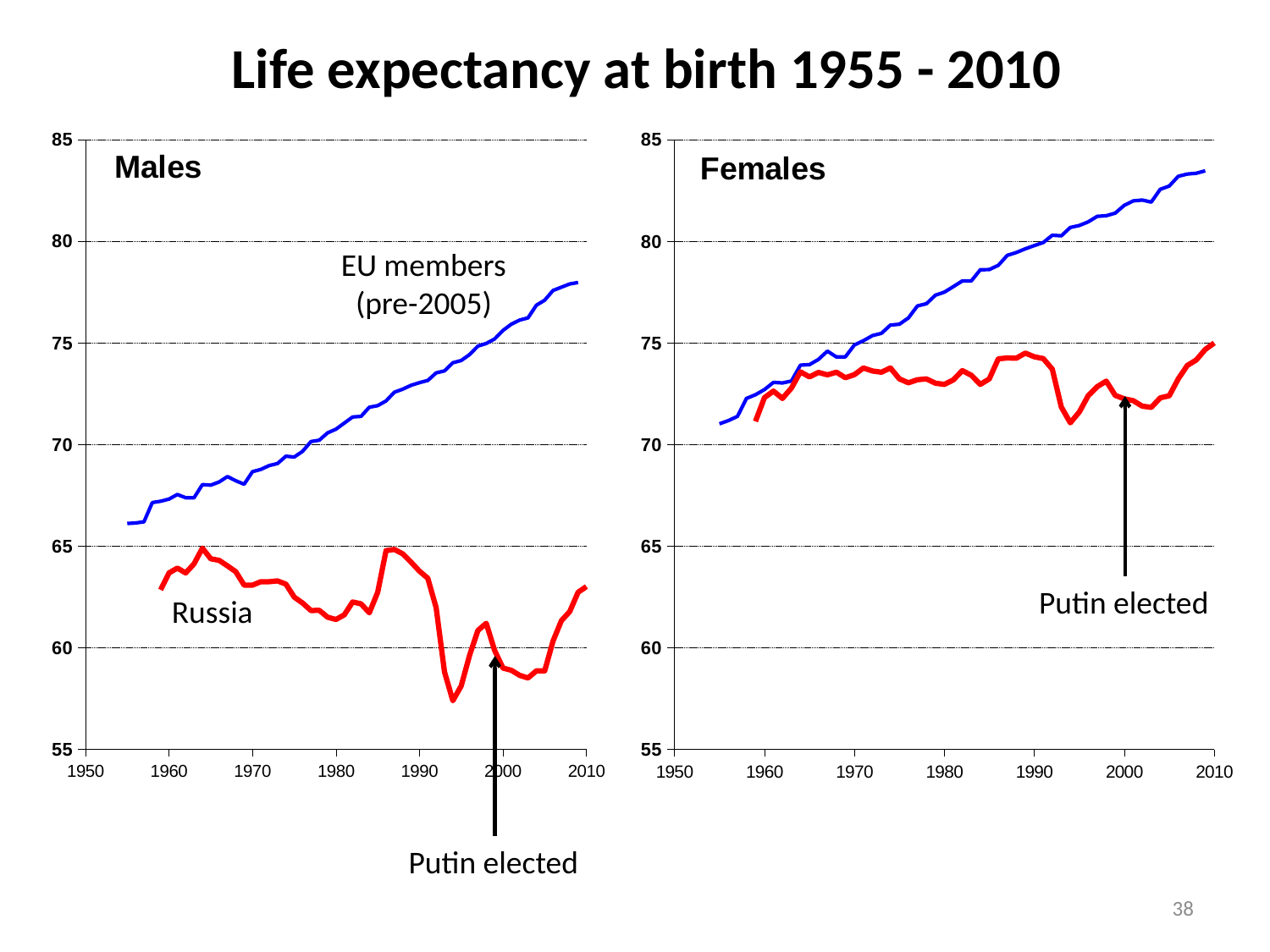
How many lines are plotted on the Males chart? 2 On the Females chart, is the value of the blue line in 2009 greater or less than 80? greater On the Males chart, is the value for Russia in 1994 greater or less than 60? less On the Males chart, which is higher in 2000, EU members (pre-2005) or Russia? EU members (pre-2005) On the Males chart, is the value for EU members (pre-2005) in 2009 greater or less than 75? greater What kind of chart is used on the Males chart? line chart What is the title of the slide? Life expectancy at birth 1955 - 2010 On the Males chart, does the EU members (pre-2005) line rise or fall from 1955 to 2010? rise